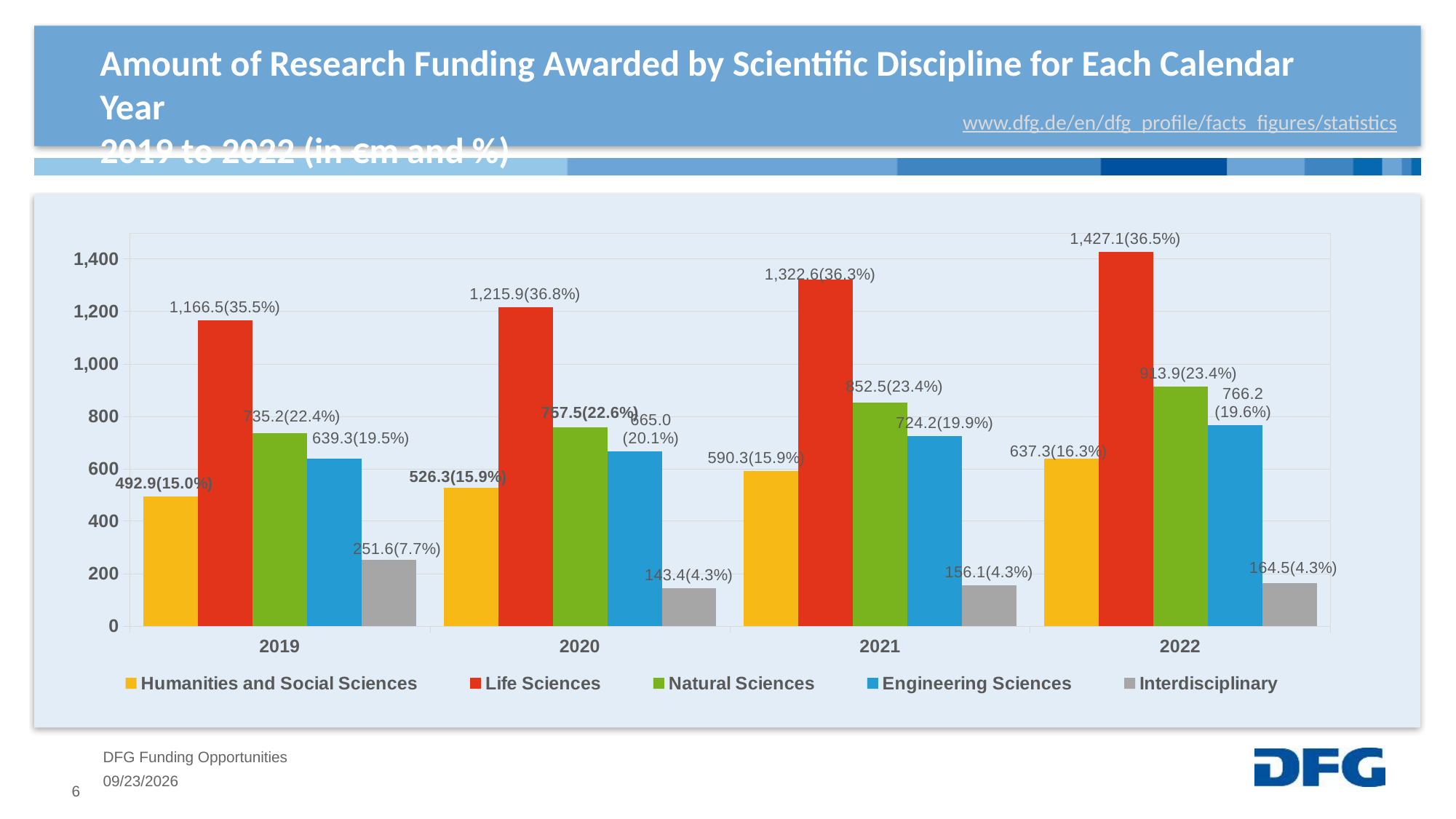
By how much did Interdisciplinary funding fall from 2019 to 2020? 108.2 How many years are shown on the x axis? 4 What amount of funding was awarded to Life Sciences in 2022? 1,427.1 Which received more funding in 2021: Natural Sciences or Engineering Sciences? Natural Sciences How many series does the legend list? 5 What amount of funding was awarded to Engineering Sciences in 2021? 724.2 What kind of chart is shown on the slide? Bar chart Is the value for Humanities and Social Sciences in 2022 greater or less than 600? greater Which discipline received the least funding in 2022? Interdisciplinary What percentage share did Humanities and Social Sciences receive in 2019? 15.0% Which discipline received the most funding in 2020? Life Sciences How much more funding did Life Sciences receive in 2022 than in 2019? 260.6